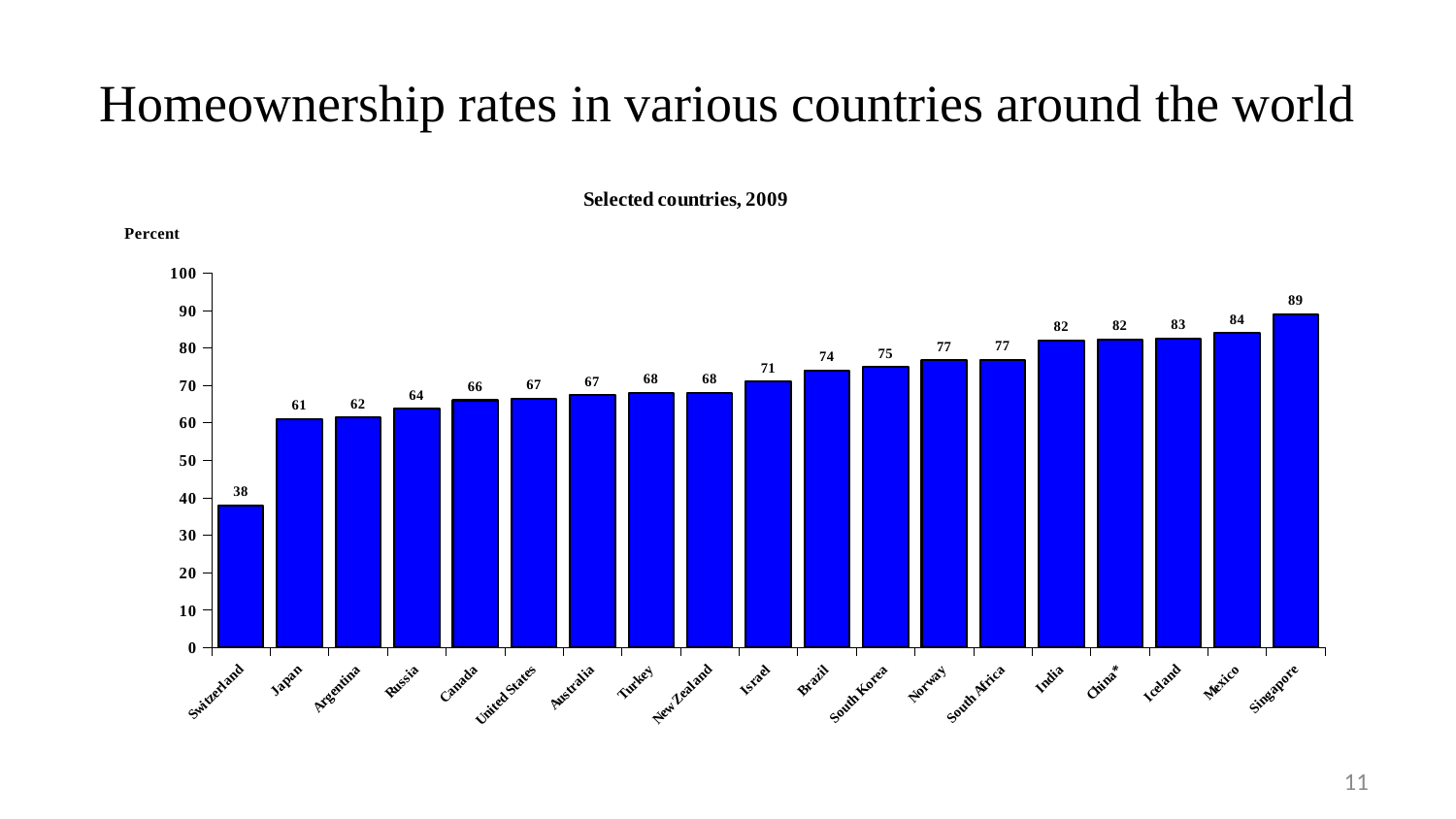
Which country has the lowest homeownership rate on the chart? Switzerland How many countries are shown on the chart? 19 What is the difference between the homeownership rates of Singapore and Switzerland? 51 What is the difference between the homeownership rates of Mexico and Japan? 23 Which has a higher homeownership rate, Norway or Canada? Norway Which country has the highest homeownership rate on the chart? Singapore What is the homeownership rate shown for Switzerland? 38 What kind of chart is shown on the slide? Bar chart What is the homeownership rate shown for Brazil? 74 Is the value for India greater or less than 80? greater What is the subtitle printed above the chart? Selected countries, 2009 What is the homeownership rate shown for the United States? 67